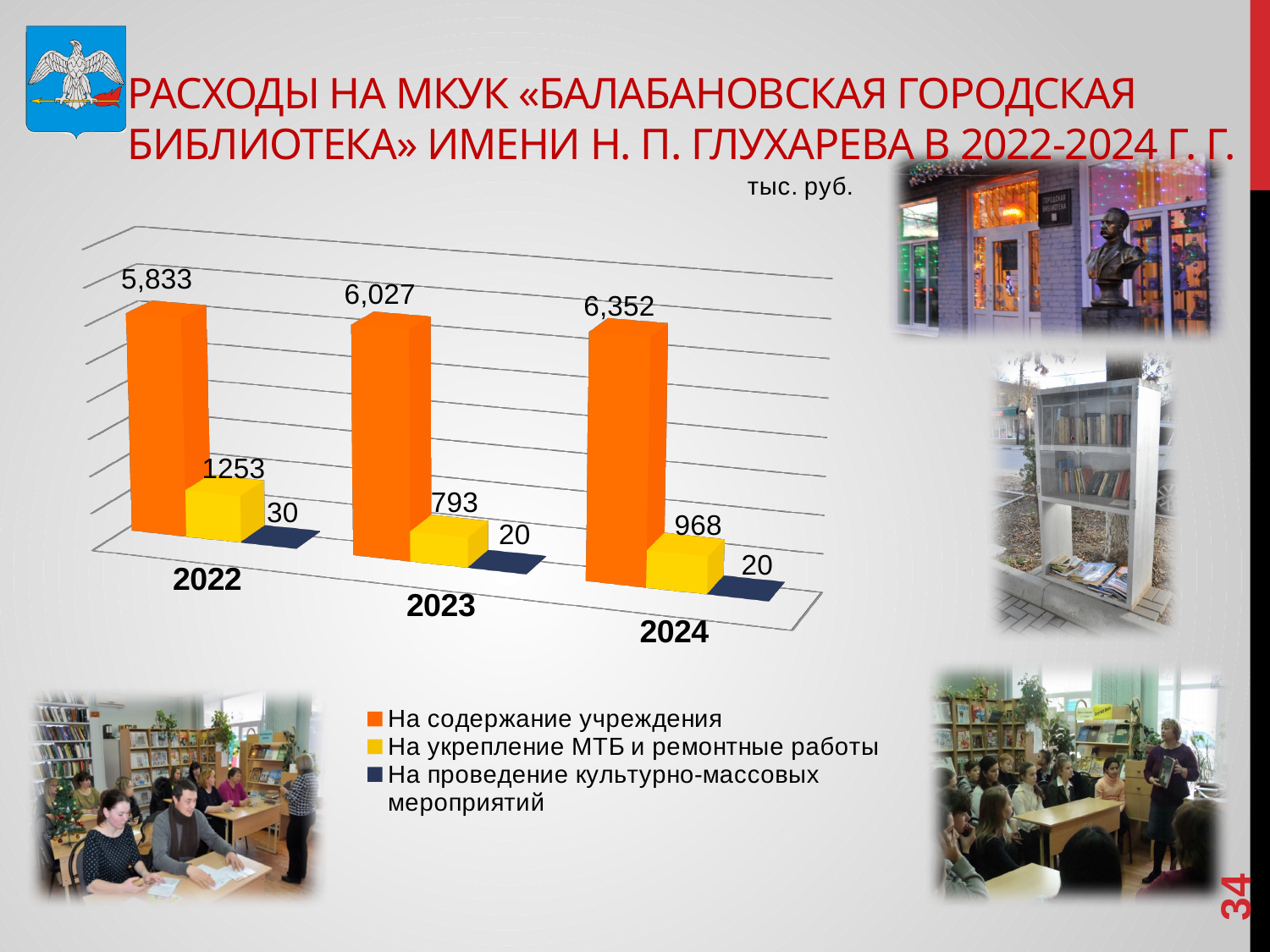
What is the value for "На содержание учреждения" in 2022? 5,833 How many years are shown on the x axis of the chart? 3 What kind of chart is shown on the slide? Bar chart What is the difference between the "На содержание учреждения" values for 2024 and 2022? 519 What is the value for "На укрепление МТБ и ремонтные работы" in 2023? 793 In which year is the value for "На содержание учреждения" highest? 2024 What is the value for "На укрепление МТБ и ремонтные работы" in 2024? 968 Does the value for "На содержание учреждения" rise or fall from 2022 to 2024? Rises How many series does the chart legend list? 3 What is the value for "На проведение культурно-массовых мероприятий" in 2024? 20 Which is larger: the "На укрепление МТБ и ремонтные работы" value in 2022 or in 2024? 2022 In which year is the value for "На укрепление МТБ и ремонтные работы" lowest? 2023